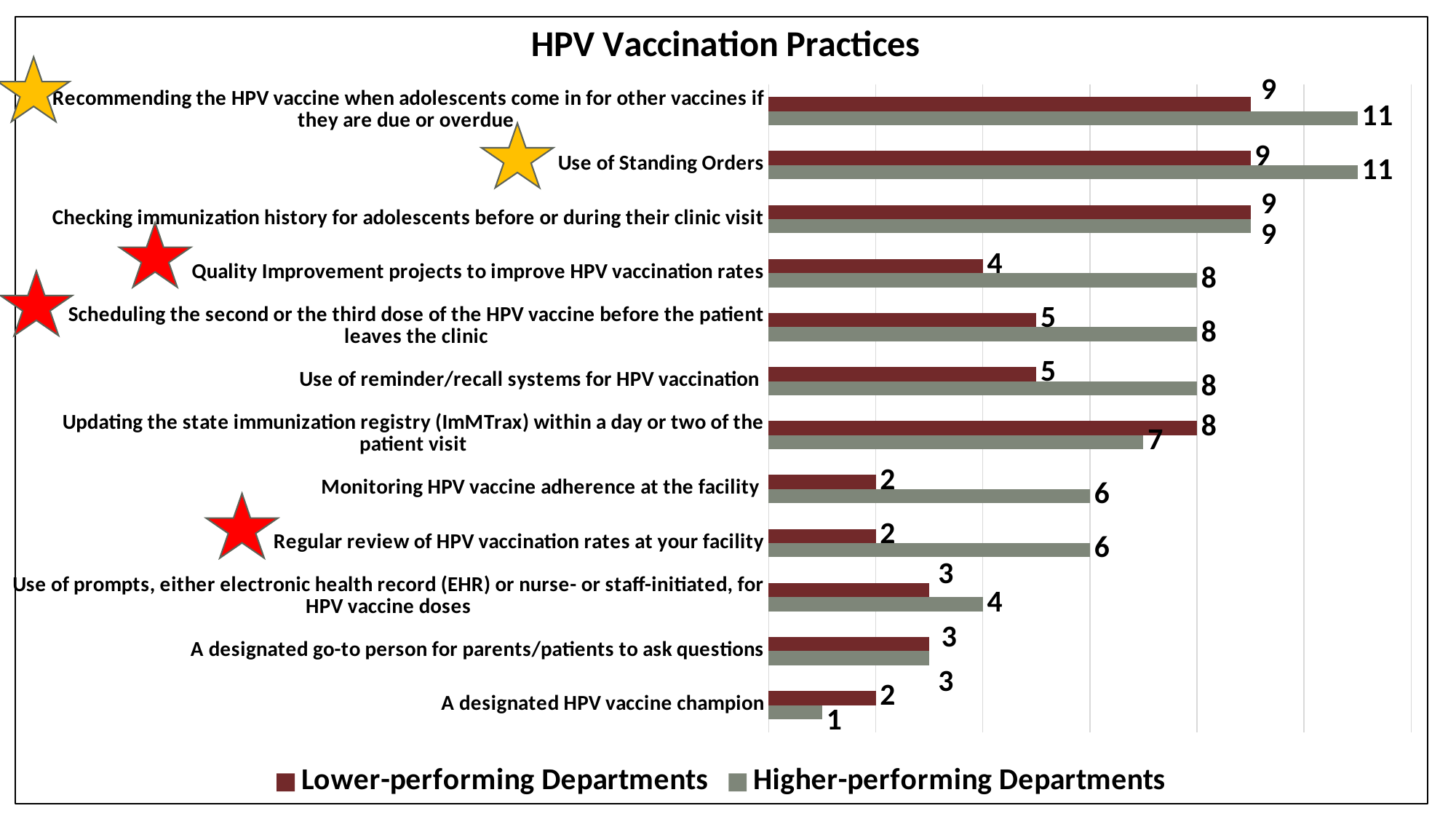
For 'Updating the state immunization registry (ImMTrax) within a day or two of the patient visit', which series has the larger value? Lower-performing Departments What is the value for Lower-performing Departments for 'Quality Improvement projects to improve HPV vaccination rates'? 4 What is the difference between Lower-performing and Higher-performing Departments for 'Updating the state immunization registry (ImMTrax) within a day or two of the patient visit'? 1 What is the value for Higher-performing Departments for 'Use of Standing Orders'? 11 How many series does the legend list? 2 What kind of chart is shown on the slide? Bar chart What is the difference between Higher-performing and Lower-performing Departments for 'Quality Improvement projects to improve HPV vaccination rates'? 4 For 'Regular review of HPV vaccination rates at your facility', which series has the larger value? Higher-performing Departments Which practice has the lowest value for Higher-performing Departments? A designated HPV vaccine champion How many practices (categories) are shown in the chart? 12 What is the value for Lower-performing Departments for 'Updating the state immunization registry (ImMTrax) within a day or two of the patient visit'? 8 What is the value for Higher-performing Departments for 'Monitoring HPV vaccine adherence at the facility'? 6